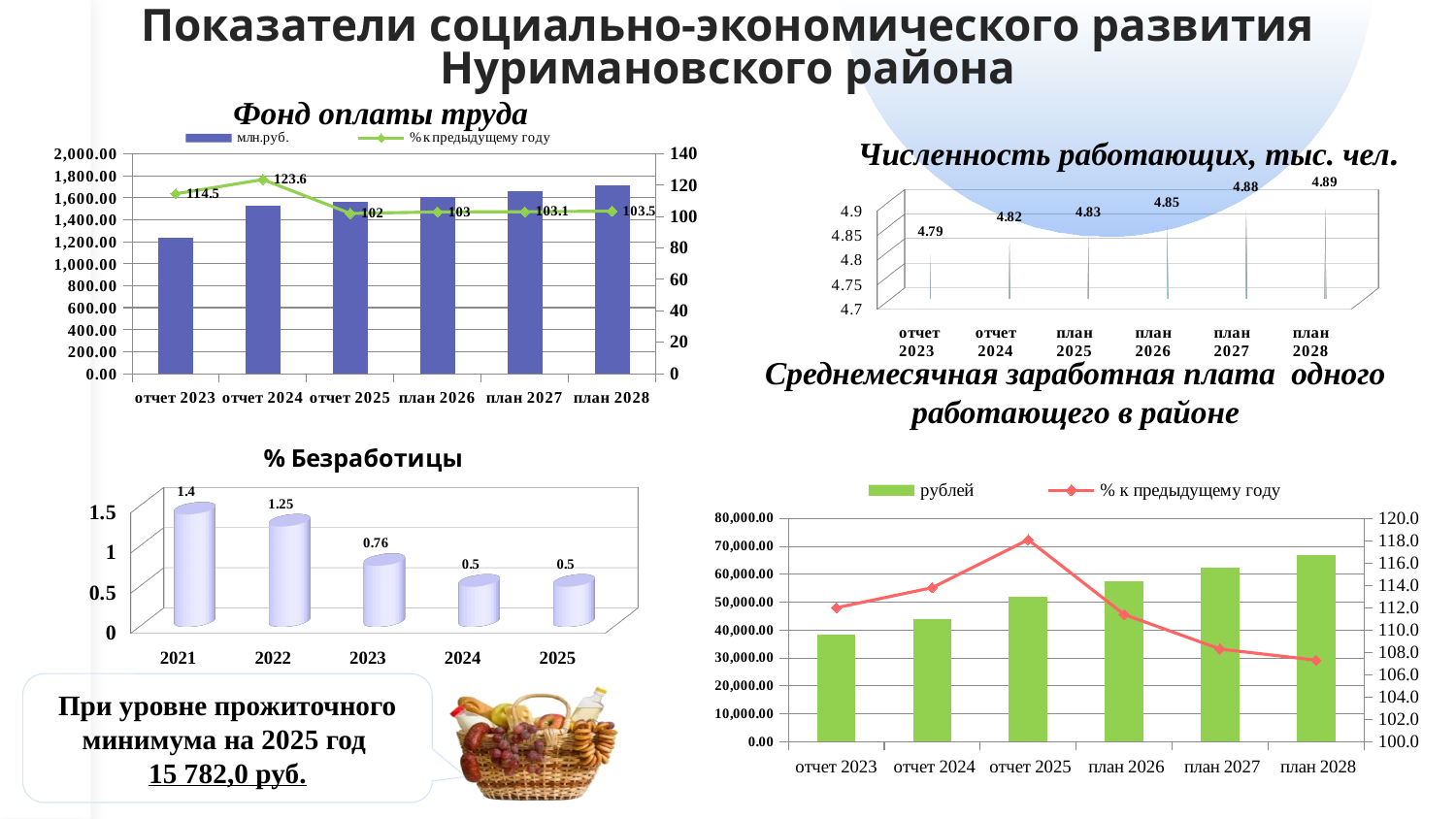
In the 'Фонд оплаты труда' chart, which category has the lowest '% к предыдущему году' value? отчет 2025 In the 'Фонд оплаты труда' chart, what is the difference between the '% к предыдущему году' values for отчет 2024 and отчет 2023? 9.1 In the '% Безработицы' chart, which year has the highest value? 2021 In the 'Численность работающих, тыс. чел.' chart, do the values rise or fall from отчет 2023 to план 2028? rise In the 'Среднемесячная заработная плата одного работающего в районе' chart, how many series does the legend list? 2 In the 'Численность работающих, тыс. чел.' chart, what is the value for план 2028? 4.89 In the 'Фонд оплаты труда' chart, what is the '% к предыдущему году' value for отчет 2024? 123.6 In the 'Среднемесячная заработная плата одного работающего в районе' chart, is the рублей bar for отчет 2023 greater or less than 40,000.00? less In the 'Фонд оплаты труда' chart, is the млн.руб. bar for отчет 2023 greater or less than 1,400.00? less In the '% Безработицы' chart, what is the difference between the values for 2021 and 2022? 0.15 In the '% Безработицы' chart, what is the value for 2023? 0.76 In the 'Численность работающих, тыс. чел.' chart, how many categories are shown on the x axis? 6